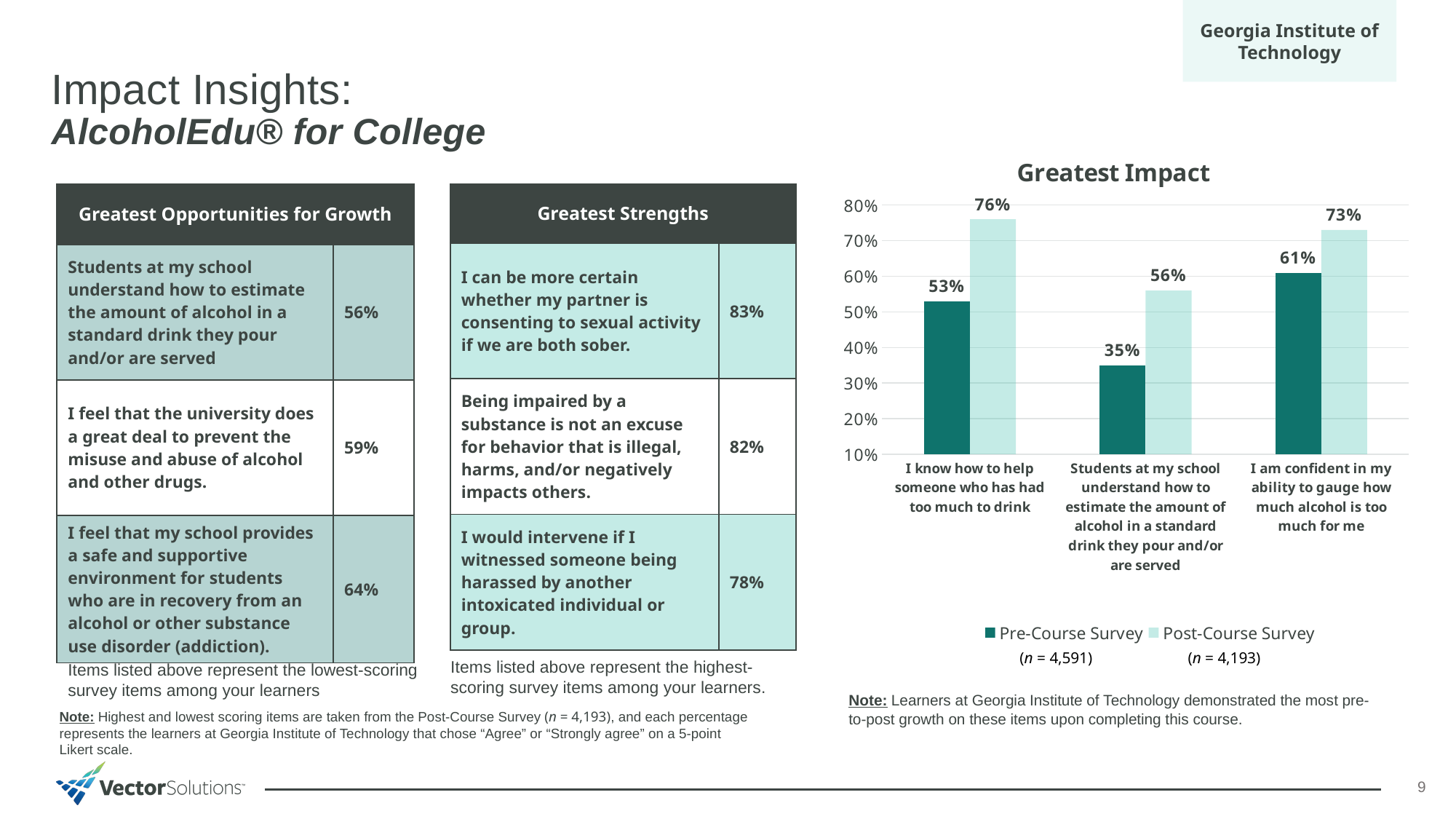
In the Greatest Impact chart, what is the Pre-Course Survey value for "I know how to help someone who has had too much to drink"? 53% In the Greatest Impact chart, what is the Post-Course Survey value for "Students at my school understand how to estimate the amount of alcohol in a standard drink they pour and/or are served"? 56% In the Greatest Impact chart, which is larger: the Pre-Course Survey value for "I am confident in my ability to gauge how much alcohol is too much for me" or the Pre-Course Survey value for "I know how to help someone who has had too much to drink"? I am confident in my ability to gauge how much alcohol is too much for me In the Greatest Impact chart, what is the difference between the Post-Course and Pre-Course Survey values for "Students at my school understand how to estimate the amount of alcohol in a standard drink they pour and/or are served"? 21% In the Greatest Impact chart, what are the two series listed in the legend? Pre-Course Survey and Post-Course Survey In the Greatest Impact chart, what is the difference between the Post-Course and Pre-Course Survey values for "I know how to help someone who has had too much to drink"? 23% In the Greatest Impact chart, which category has the lowest Pre-Course Survey value? Students at my school understand how to estimate the amount of alcohol in a standard drink they pour and/or are served In the Greatest Impact chart, how many series does the legend list? 2 In the Greatest Impact chart, how many categories are shown on the x axis? 3 What kind of chart is the Greatest Impact chart? Bar chart In the Greatest Impact chart, which category has the highest Post-Course Survey value? I know how to help someone who has had too much to drink In the Greatest Impact chart, what is the Post-Course Survey value for "I am confident in my ability to gauge how much alcohol is too much for me"? 73%